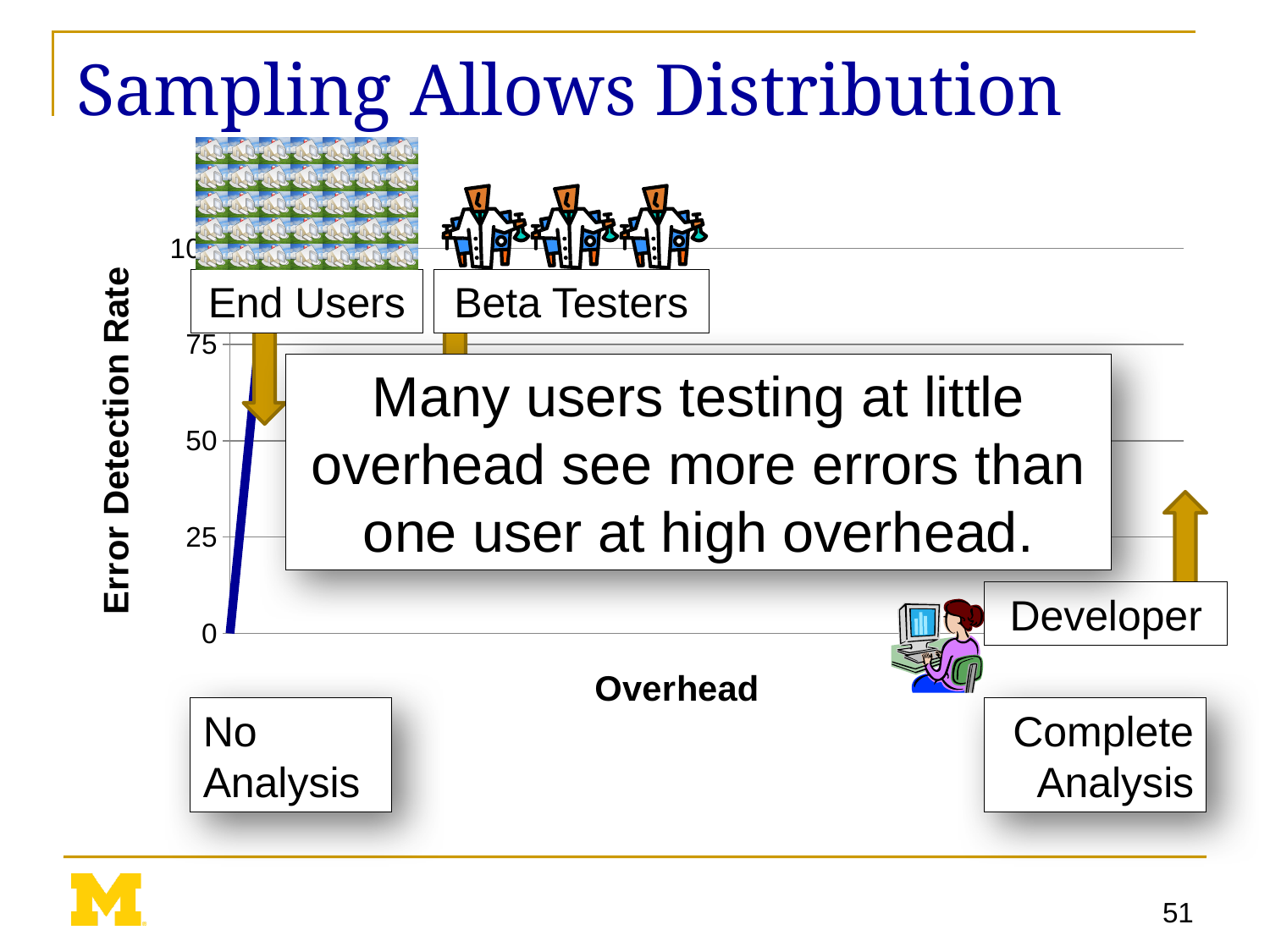
How many labelled tick marks are shown on the vertical axis of the chart? 5 What is the label of the horizontal axis of the chart? Overhead What is the label of the vertical axis of the chart? Error Detection Rate What is the lowest value shown on the vertical axis of the chart? 0 What kind of chart is shown on the slide? line chart Does the plotted line rise or fall as it moves to the right from the left edge of the chart? rise What value does the plotted line start at on the vertical axis at the left edge of the chart? 0